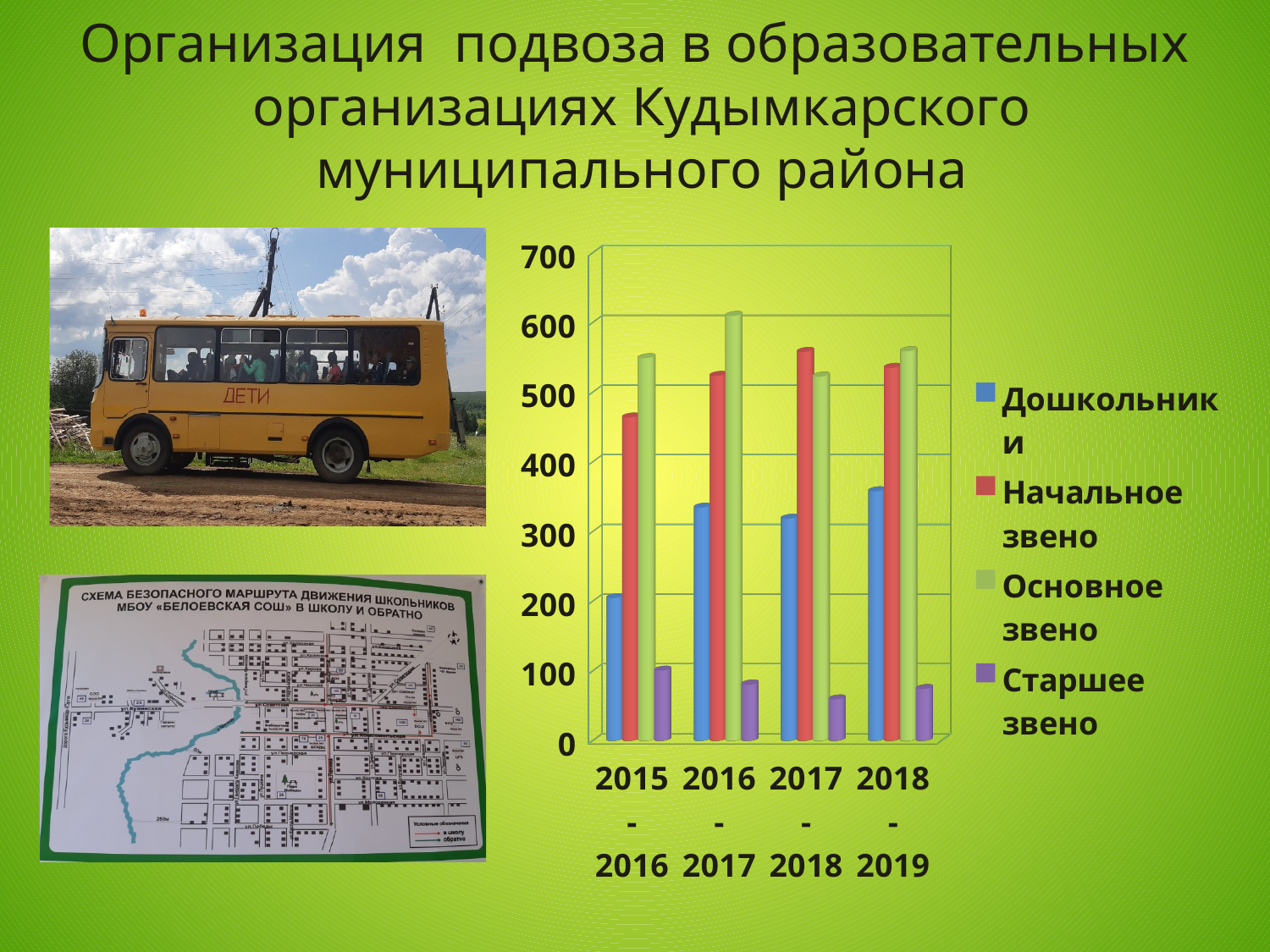
In which school year is the value for Основное звено the highest? 2016-2017 In which school year is the value for Дошкольники the lowest? 2015-2016 Which colour represents Начальное звено in the chart legend? red How many series does the chart legend list? 4 Is the value for Начальное звено in 2015-2016 greater or less than 500? less How many school-year categories are shown on the x axis of the chart? 4 In 2017-2018, which is larger: Начальное звено or Основное звено? Начальное звено Is the value for Старшее звено in 2017-2018 greater or less than 100? less What kind of chart is shown on the slide? bar chart Is the value for Дошкольники in 2015-2016 greater or less than 300? less Which series has the shortest bar in every school year shown? Старшее звено Which series has the tallest bar in 2016-2017? Основное звено